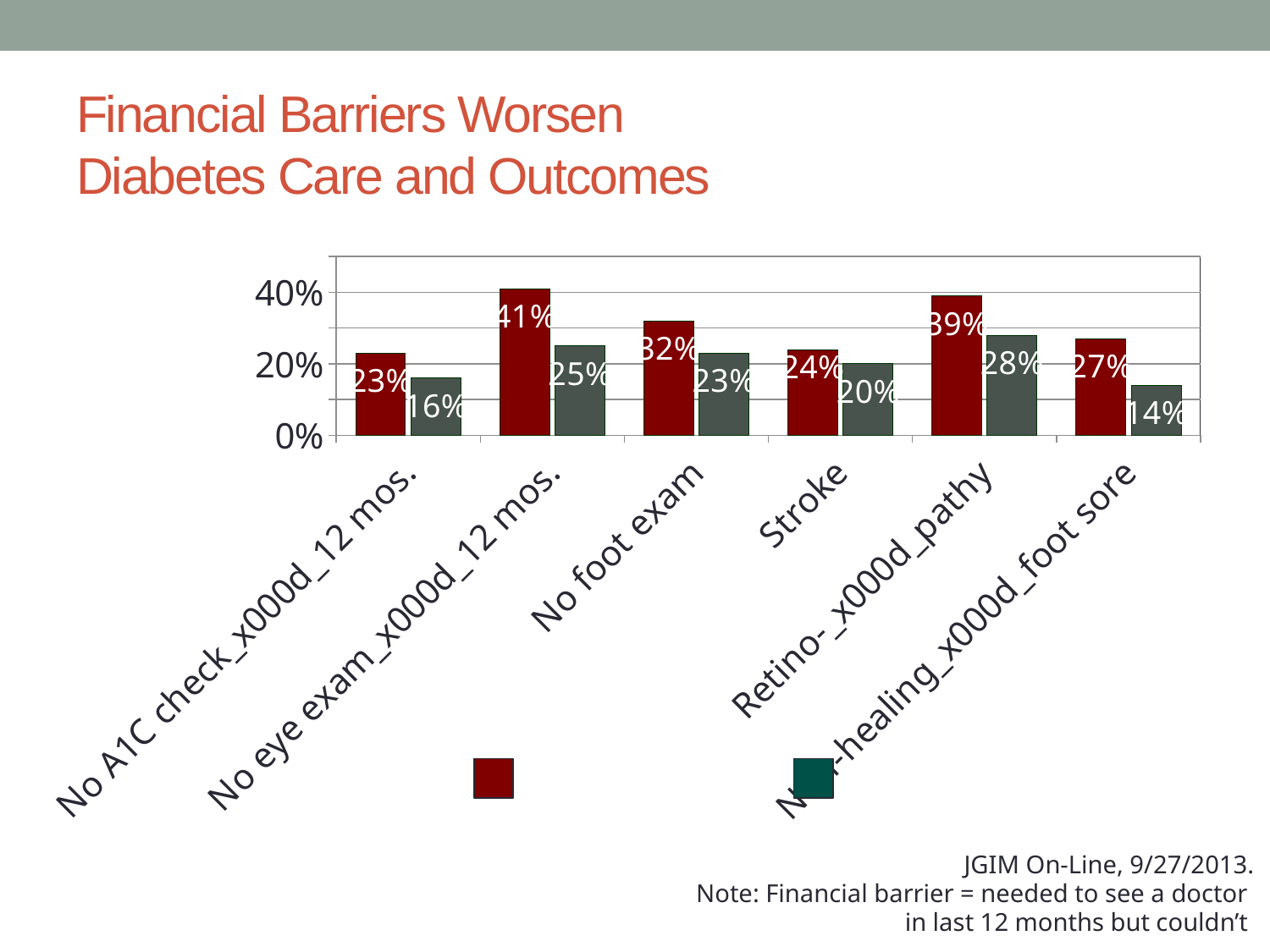
What is the value of the red bar for "No eye exam 12 mos."? 41% What is the value of the dark green bar for "Stroke"? 20% How many categories are shown on the x axis? 6 Which category has the lowest dark green bar? Non-healing foot sore For "Retinopathy", which bar is larger, the red or the dark green? red What is the difference between the red and dark green bars for "No eye exam 12 mos."? 16% Which category has the highest red bar? No eye exam 12 mos. Is the dark green bar for "Retinopathy" greater or less than 20%? greater What is the value of the red bar for "No foot exam"? 32% What kind of chart is shown on the slide? bar chart What is the value of the dark green bar for "No A1C check 12 mos."? 16% What is the difference between the red and dark green bars for "No foot exam"? 9%